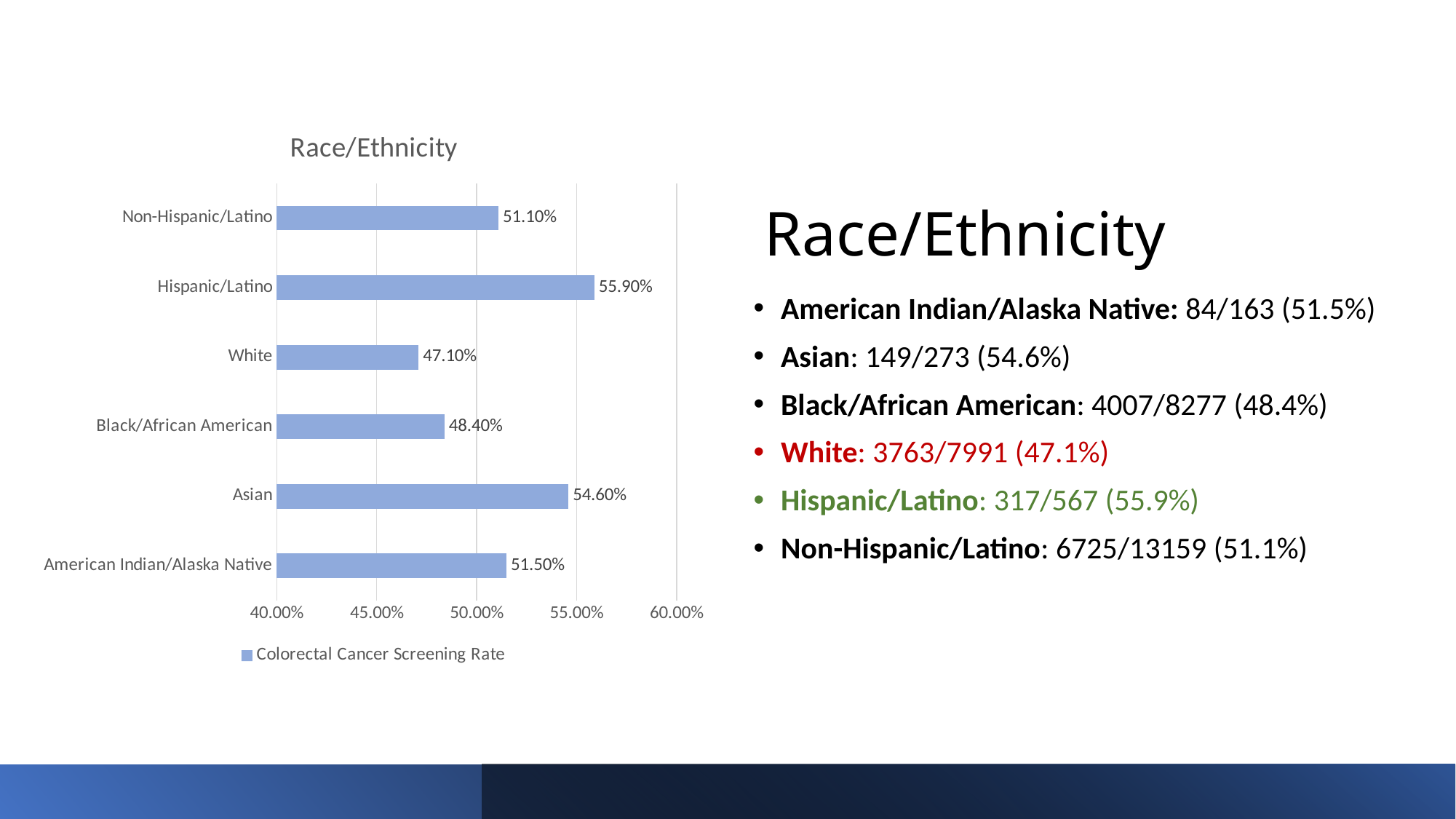
Is the screening rate for Black/African American greater or less than 50.00%? less What is the difference between the screening rates for Hispanic/Latino and Non-Hispanic/Latino? 4.80% Which has a higher screening rate, Asian or American Indian/Alaska Native? Asian Which race/ethnicity category has the highest screening rate? Hispanic/Latino How many series does the chart legend list? 1 What is the legend entry for the series in the chart? Colorectal Cancer Screening Rate What is the colorectal cancer screening rate for White? 47.10% What type of chart is shown on the slide? Bar chart What is the colorectal cancer screening rate for Hispanic/Latino? 55.90% Which race/ethnicity category has the lowest screening rate? White What is the colorectal cancer screening rate for Black/African American? 48.40% How many race/ethnicity categories are shown in the chart? 6